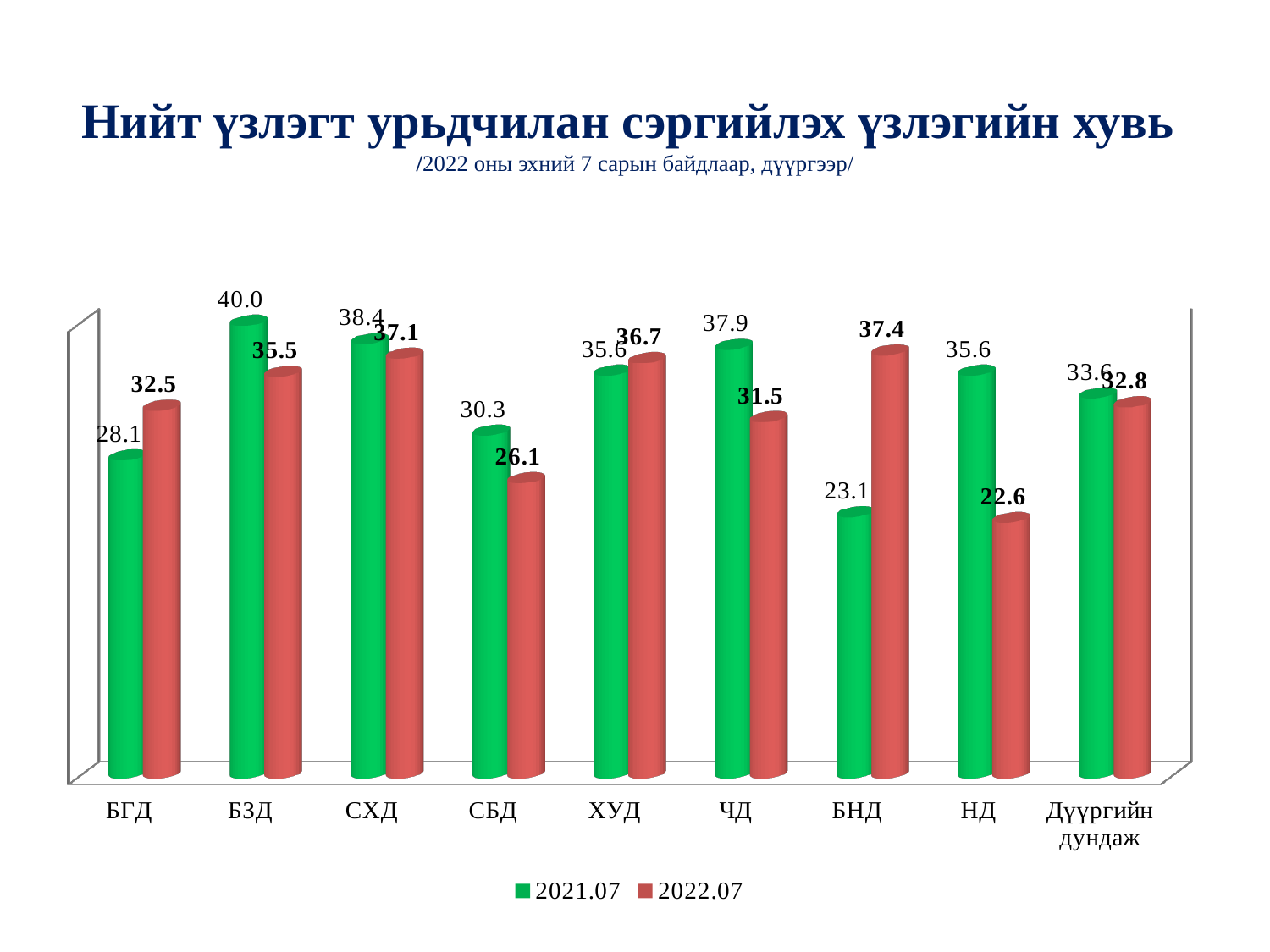
What is the value for БНД in the 2022.07 series? 37.4 What is the difference between the 2021.07 and 2022.07 values for НД? 13.0 How many series does the legend list? 2 For СБД, which series has the larger value, 2021.07 or 2022.07? 2021.07 Which category has the highest value in the 2021.07 series? БЗД What is the difference between the 2022.07 and 2021.07 values for БНД? 14.3 Which category has the lowest value in the 2021.07 series? БНД What is the value for Дүүргийн дундаж in the 2022.07 series? 32.8 Which category has the lowest value in the 2022.07 series? НД What kind of chart is shown on the slide? Bar chart How many categories are shown on the x axis? 9 What is the value for БЗД in the 2021.07 series? 40.0